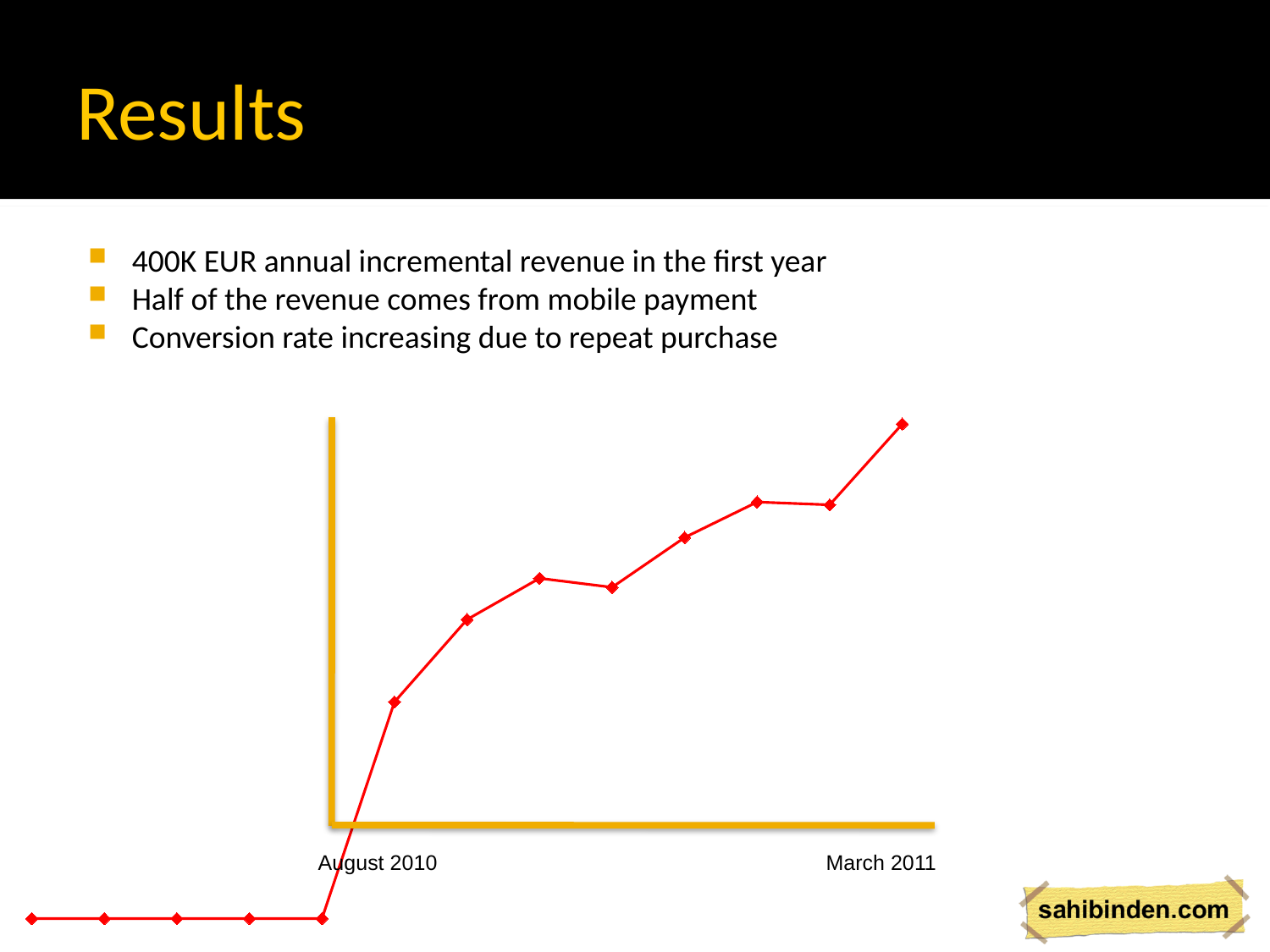
What are the two date labels shown along the x axis? August 2010 and March 2011 Before August 2010, does the line rise, fall, or stay flat? stay flat How many series are plotted on the chart? 1 How many data points are plotted on the line? 13 Which of the two labelled dates, August 2010 or March 2011, has the higher value on the line? March 2011 At which labelled date does the line reach its highest point? March 2011 Is the last point on the line higher or lower than the first point? higher What colour is the plotted line? red What kind of chart is shown on the slide? line chart Does the line generally rise or fall from August 2010 to March 2011? rise